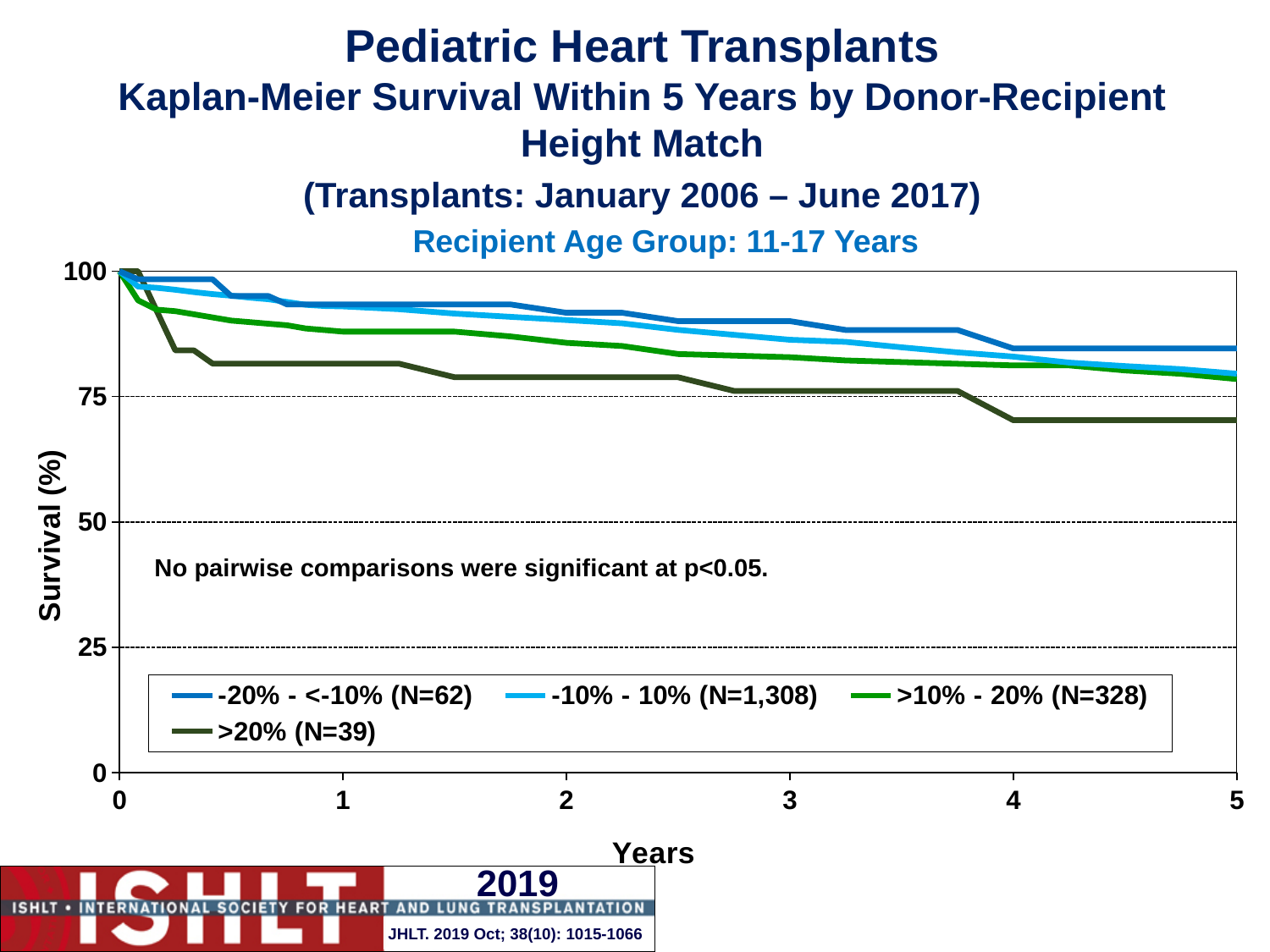
Which height-match group has the highest survival at 5 years? -20% - <-10% (N=62) How many series does the legend list? 4 What is the maximum value shown on the x axis (Years)? 5 At 5 years, which group has higher survival: -20% - <-10% (N=62) or >20% (N=39)? -20% - <-10% (N=62) Is the survival for the -10% - 10% (N=1,308) group at 5 years greater or less than 75? greater Is the survival for the >20% (N=39) group at 1 year greater or less than 75? greater What kind of chart is shown on the slide? line chart Is the survival for the >20% (N=39) group at 5 years greater or less than 75? less Which height-match group has the lowest survival at 5 years? >20% (N=39) What is the N for the -10% - 10% group shown in the legend? 1,308 Do the survival curves rise or fall as years increase? fall What is the label of the y axis? Survival (%)